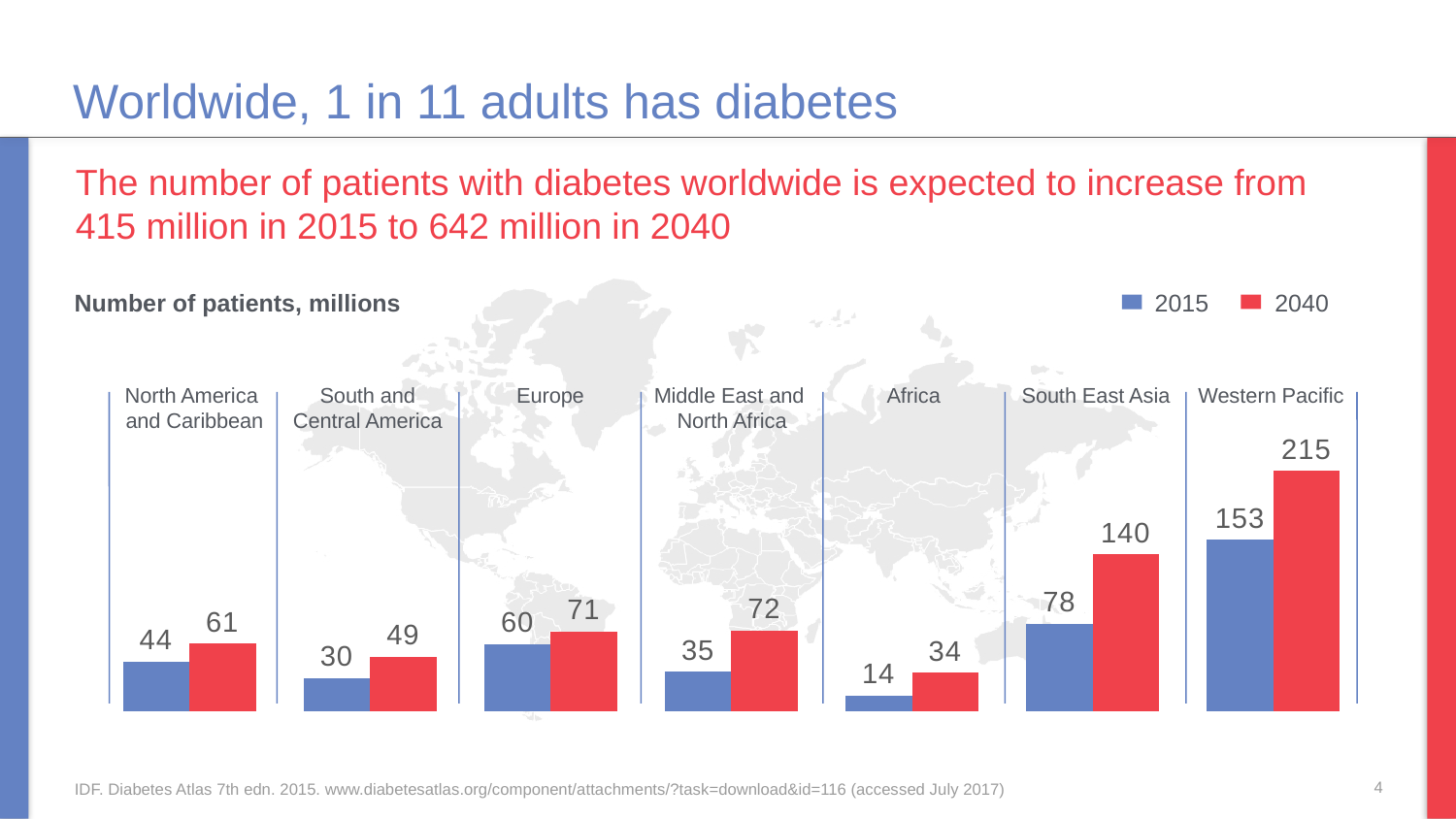
What is the number of patients (millions) for Western Pacific in 2040? 215 Which region has the highest number of patients in 2040? Western Pacific How many series does the legend list? 2 What is the number of patients (millions) for Europe in 2015? 60 What kind of chart is shown on the slide? Bar chart How many regions are shown in the chart? 7 What is the difference between the 2040 and 2015 values for South East Asia? 62 What is the number of patients (millions) for Africa in 2015? 14 Which colour represents the 2040 series in the chart? Red Which is larger: the 2040 value for Europe or the 2040 value for Middle East and North Africa? Middle East and North Africa What is the difference between the 2040 values for Western Pacific and South East Asia? 75 Which region has the lowest number of patients in 2015? Africa